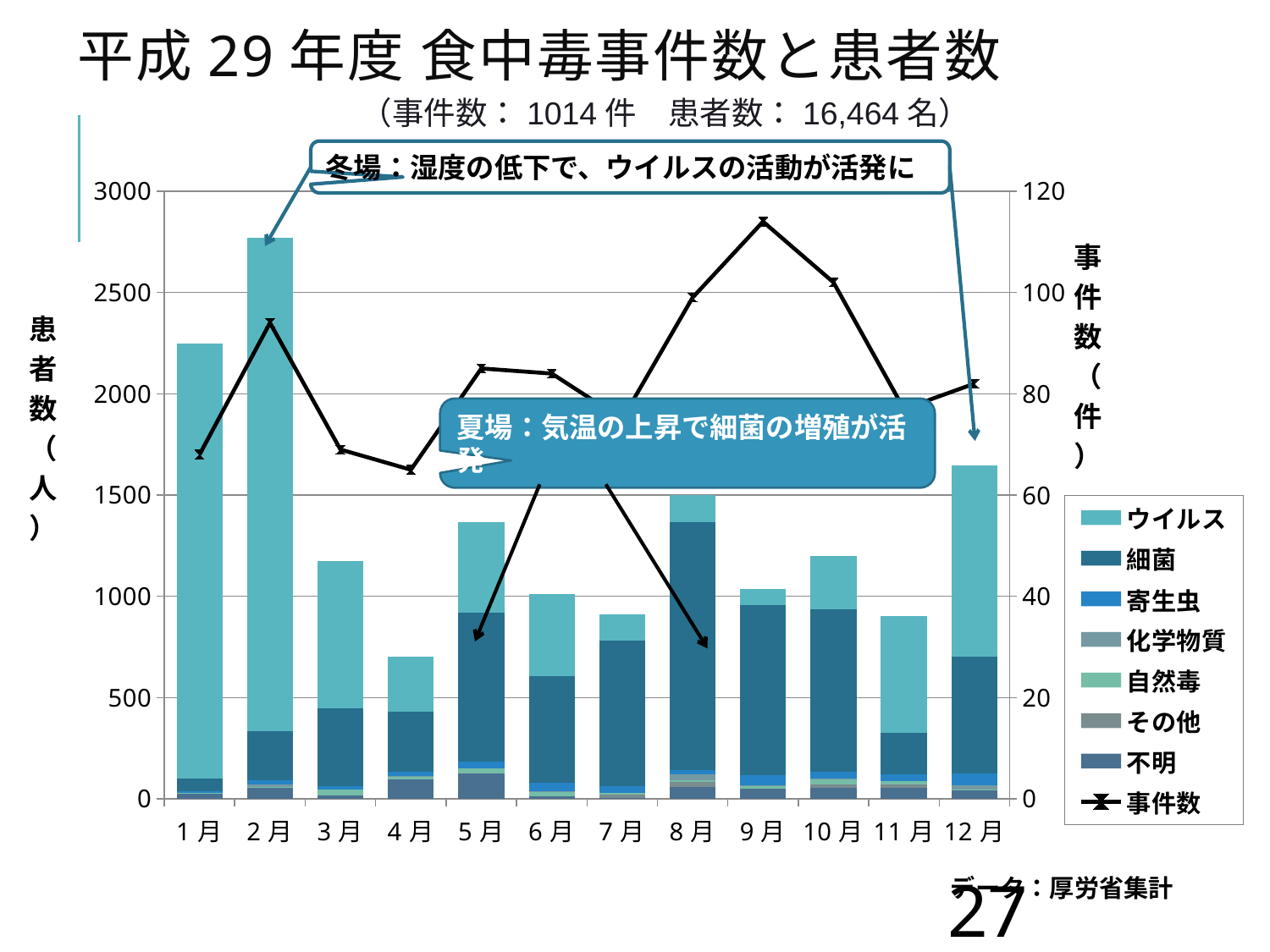
Which month has the tallest stacked bar for 患者数? 2月 Is the 事件数 value for 9月 greater or less than 100? greater How many series does the legend list? 8 Is the total 患者数 bar for 4月 greater or less than 1000? less In which month does the 事件数 line reach its highest point? 9月 Which month has the shortest stacked bar for 患者数? 4月 Which month has the larger total 患者数 bar, 7月 or 8月? 8月 How many months (categories) are shown on the x axis? 12 Does the 事件数 line rise or fall from 9月 to 11月? fall Is the total 患者数 bar for 2月 greater or less than 2500? greater In which month is the 事件数 line at its lowest point? 4月 What kind of chart is shown on the slide? A stacked bar chart combined with a line chart